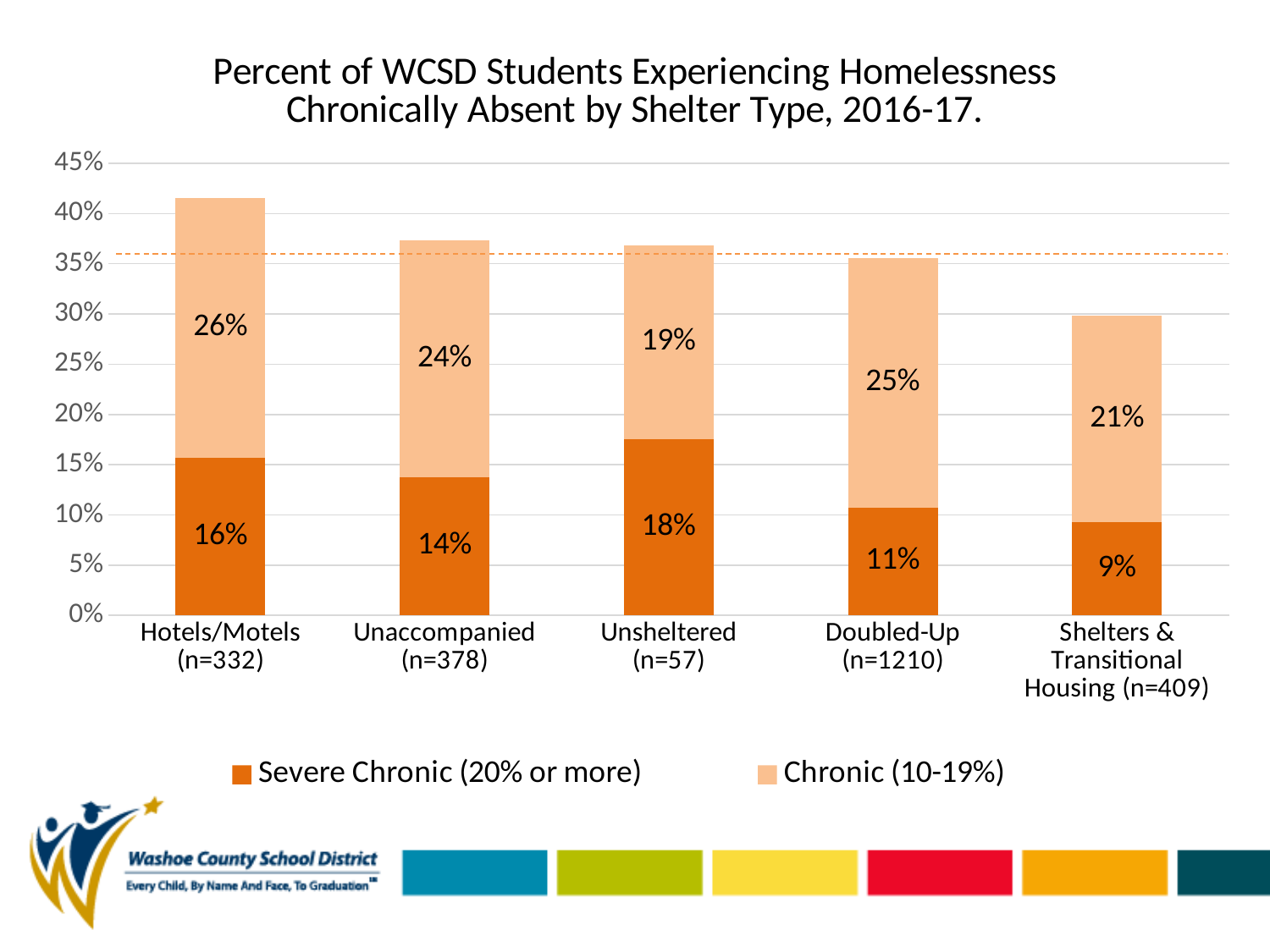
How many series does the legend list? 2 How many shelter type categories are shown on the x axis? 5 Which shelter type has the tallest overall stacked bar? Hotels/Motels (n=332) Which shelter type has the highest Chronic (10-19%) value? Hotels/Motels (n=332) What is the Chronic (10-19%) value for Doubled-Up (n=1210)? 25% What is the difference between the Severe Chronic values for Unsheltered and Shelters & Transitional Housing? 9 percentage points Which shelter type has the highest Severe Chronic (20% or more) value? Unsheltered (n=57) Is the total stacked bar for Shelters & Transitional Housing greater or less than 35%? less What is the Chronic (10-19%) value for Shelters & Transitional Housing (n=409)? 21% What is the Severe Chronic (20% or more) value for Hotels/Motels (n=332)? 16% Which has a larger Chronic (10-19%) value, Unaccompanied or Doubled-Up? Doubled-Up Which shelter type has the lowest Severe Chronic (20% or more) value? Shelters & Transitional Housing (n=409)